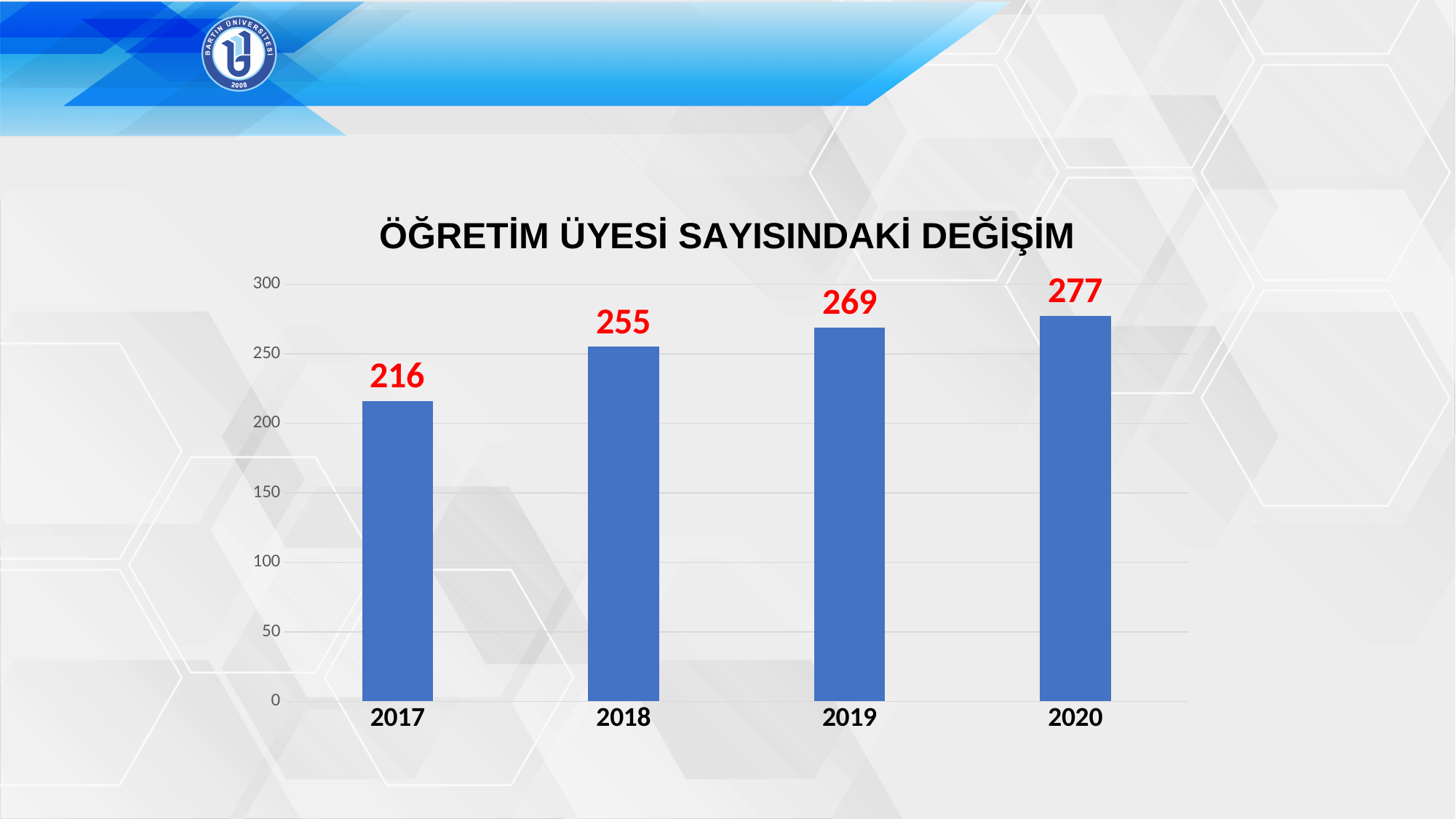
What is the value for 2019? 269 What is the value for 2017? 216 Which year has the lowest value? 2017 What is the difference between the values for 2020 and 2017? 61 What is the difference between the values for 2018 and 2017? 39 Do the values rise or fall from 2017 to 2020? Rise What is the value for 2018? 255 Which is larger, the value for 2018 or the value for 2019? 2019 What kind of chart is shown on the slide? Bar chart How many years are shown on the chart? 4 Which year has the highest value? 2020 What is the value for 2020? 277